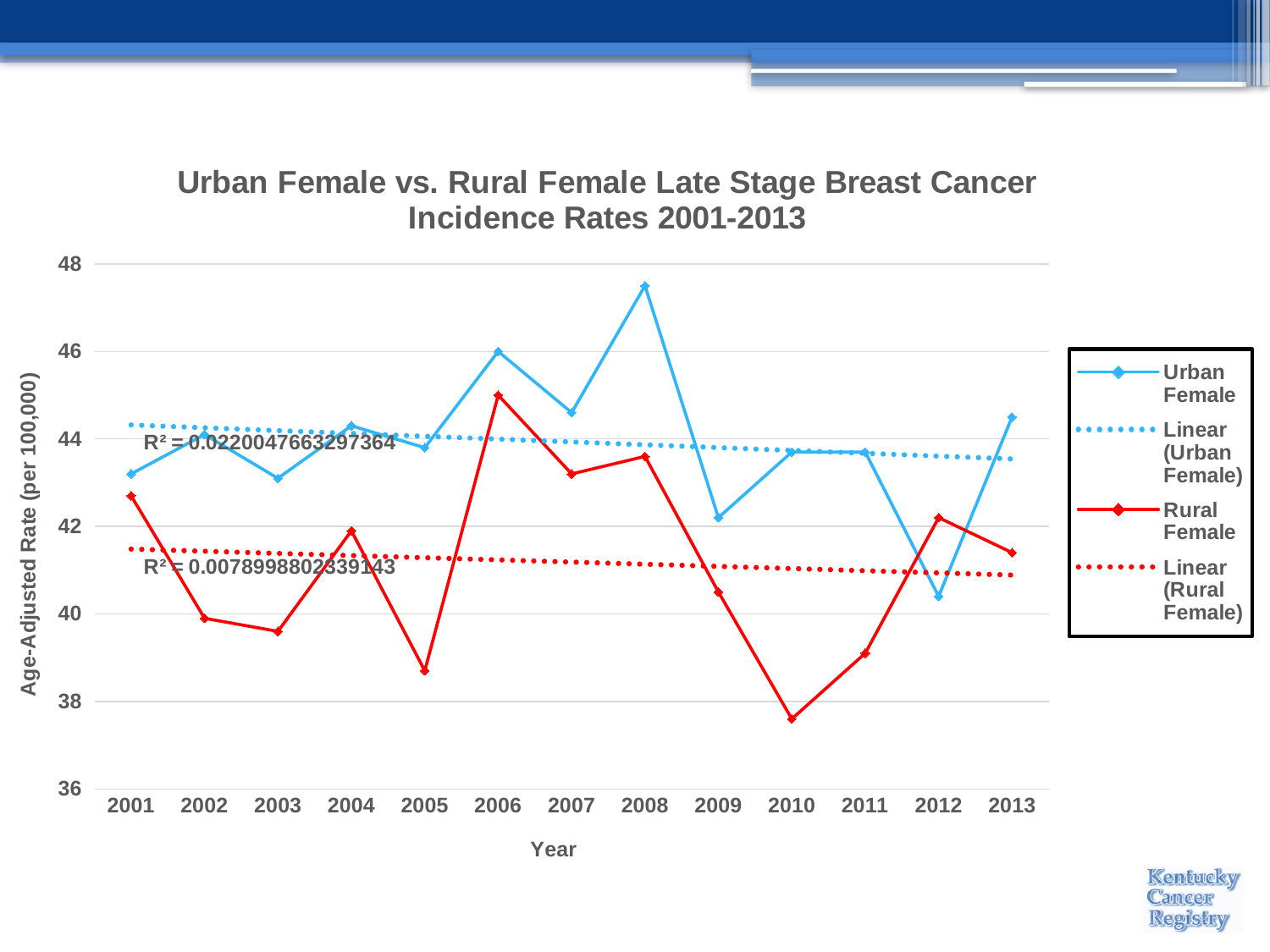
Is the Urban Female value for 2008 greater or less than 46? greater What kind of chart is shown on the slide? Line chart In which year does the Rural Female series reach its highest value? 2006 Is the Rural Female value for 2010 greater or less than 38? less Does the Rural Female series rise or fall from 2009 to 2010? Fall What is the R² value shown for the Linear (Urban Female) trendline? 0.0220047663297364 How many entries does the legend list? 4 In which year does the Urban Female series reach its lowest value? 2012 How many years are plotted along the x axis? 13 In which year does the Urban Female series reach its highest value? 2008 In which year does the Rural Female series reach its lowest value? 2010 In 2005, which series has the larger value, Urban Female or Rural Female? Urban Female